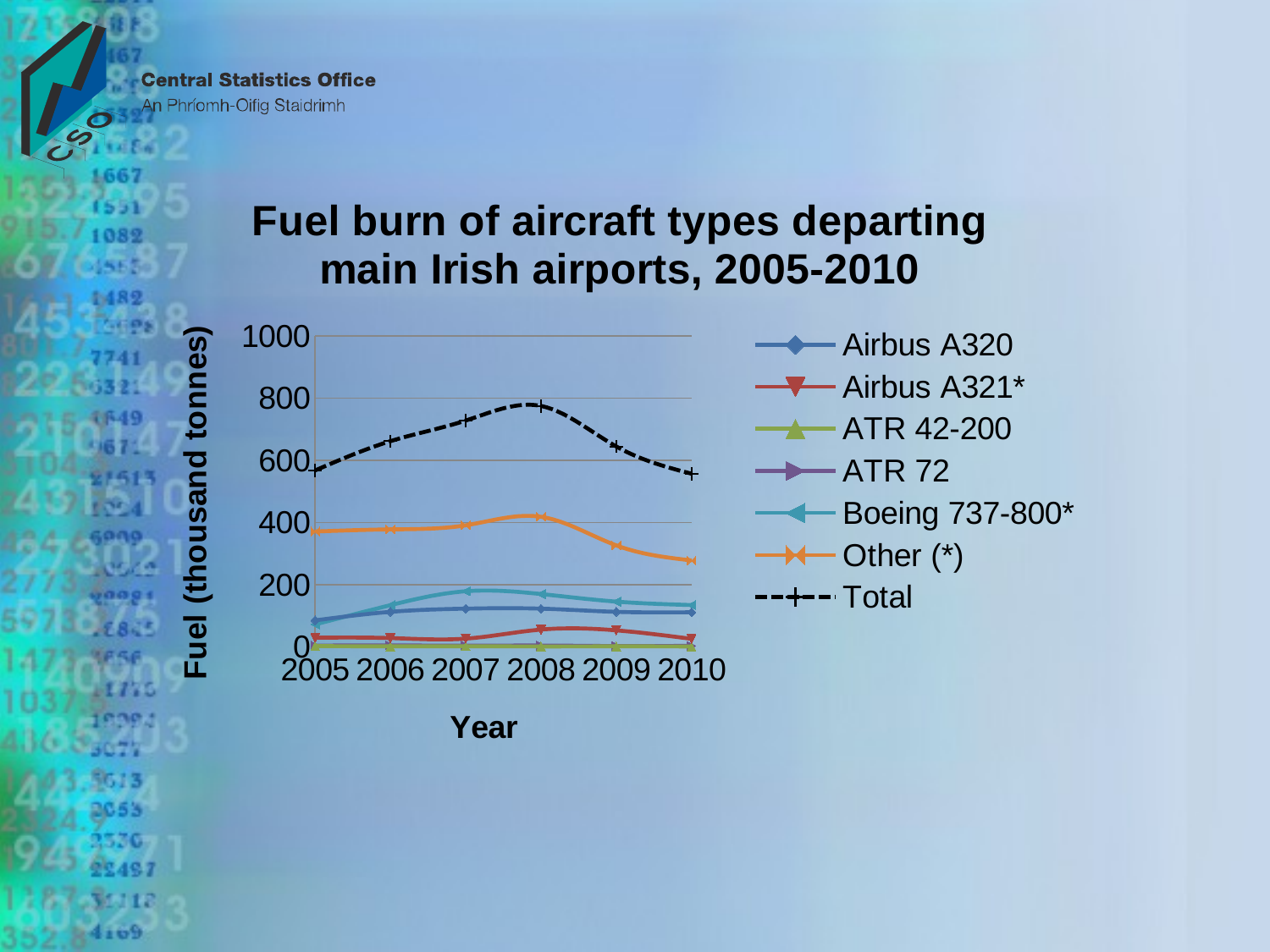
Is the value for Total in 2008 greater or less than 600? greater Which series has the highest values across all years? Total In which year does the Total series reach its highest value? 2008 Is the value for Airbus A320 in 2005 greater or less than 200? less Which is larger, the Total value in 2008 or the Total value in 2010? 2008 What is the label of the vertical axis? Fuel (thousand tonnes) What kind of chart is shown on the slide? Line chart How many years are plotted along the x axis? 6 What is the title of the chart? Fuel burn of aircraft types departing main Irish airports, 2005-2010 Is the value for Other (*) in 2010 greater or less than 400? less Does the Total series rise or fall from 2008 to 2010? Fall How many series does the legend list? 7